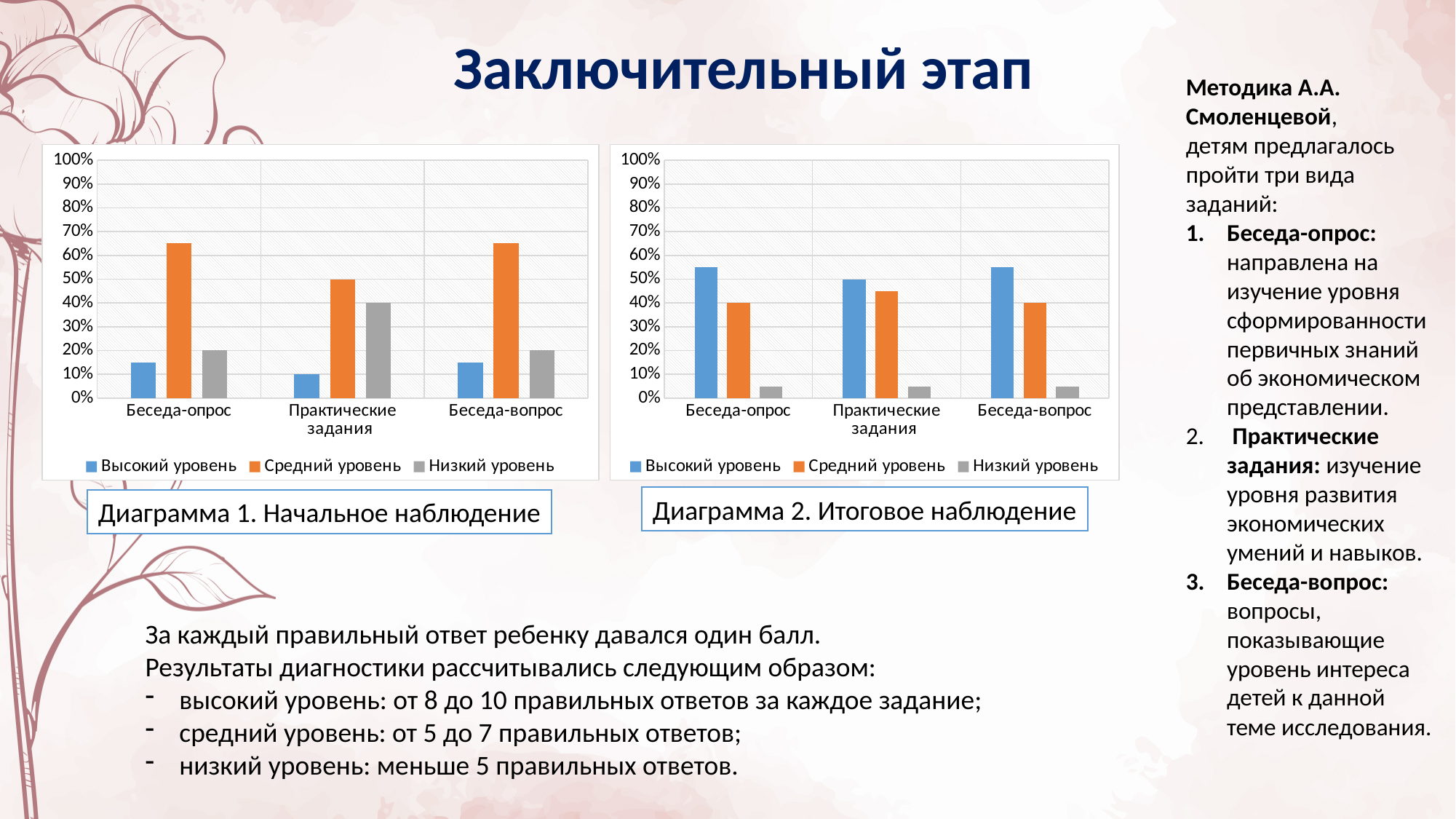
What kind of chart is Диаграмма 1. Начальное наблюдение? bar chart In Диаграмма 1. Начальное наблюдение, which series has the highest value for Беседа-опрос? Средний уровень How many series does the legend of Диаграмма 2. Итоговое наблюдение list? 3 In Диаграмма 2. Итоговое наблюдение, is the value of Высокий уровень for Беседа-опрос greater or less than 50%? greater In Диаграмма 2. Итоговое наблюдение, which series has the lowest value for Беседа-вопрос? Низкий уровень In Диаграмма 1. Начальное наблюдение, what is the difference between Средний уровень and Низкий уровень for Практические задания? 10% In Диаграмма 1. Начальное наблюдение, what is the value of Средний уровень for Практические задания? 50% How many categories are shown on the x axis of Диаграмма 1. Начальное наблюдение? 3 In Диаграмма 1. Начальное наблюдение, what is the value of Низкий уровень for Практические задания? 40% In Диаграмма 2. Итоговое наблюдение, what is the value of Средний уровень for Беседа-опрос? 40% In Диаграмма 1. Начальное наблюдение, what is the value of Высокий уровень for Практические задания? 10% In Диаграмма 2. Итоговое наблюдение, what is the value of Высокий уровень for Практические задания? 50%